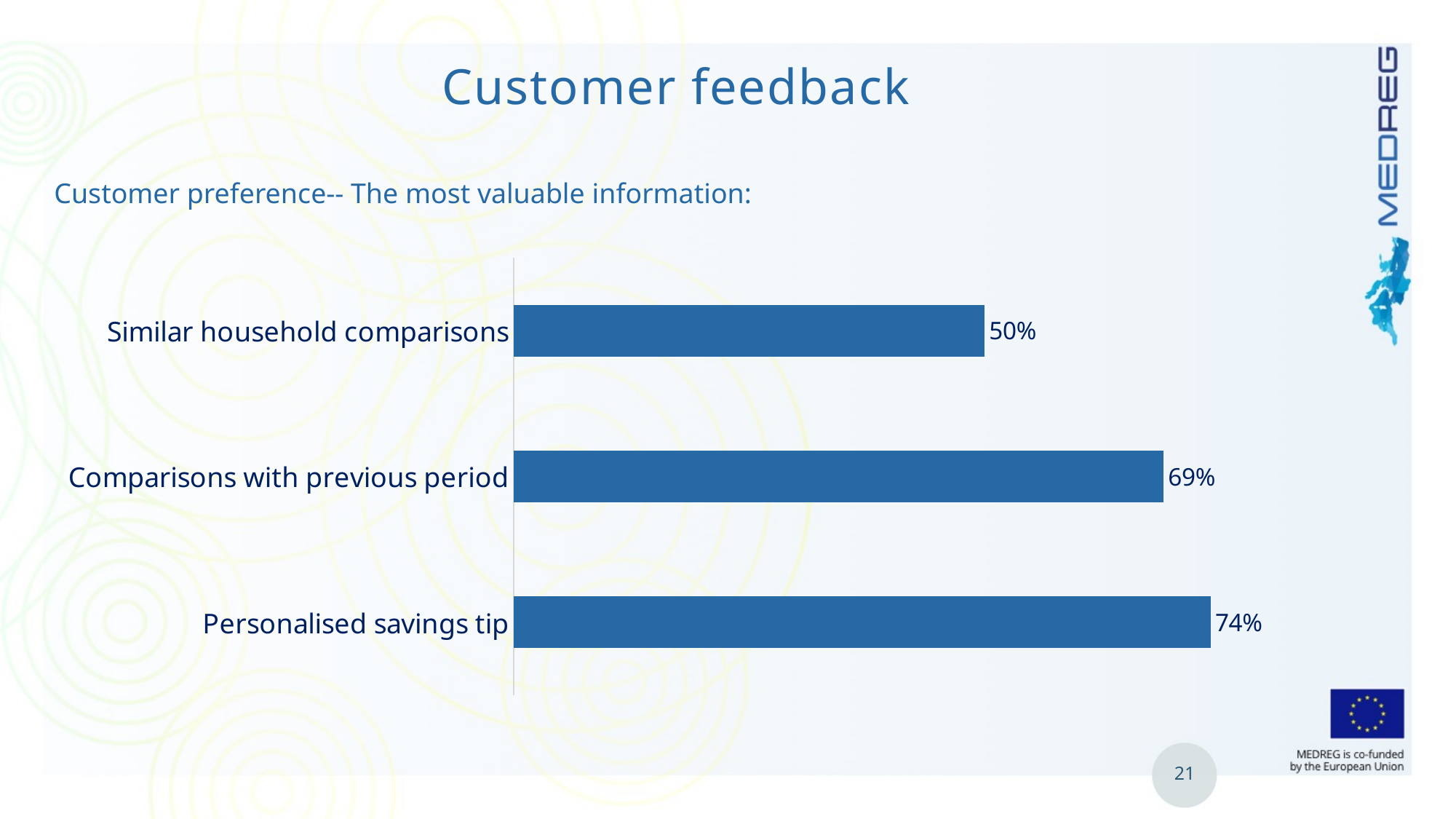
What is the value for Similar household comparisons? 50% What is the value for Comparisons with previous period? 69% Which is larger, the value for Comparisons with previous period or the value for Similar household comparisons? Comparisons with previous period How many categories are shown in the chart? 3 What is the title of the slide containing the chart? Customer feedback What kind of chart is shown on the slide? Bar chart What is the difference between the values for Comparisons with previous period and Similar household comparisons? 19% Which category has the highest value? Personalised savings tip What is the value for Personalised savings tip? 74% What is the difference between the values for Personalised savings tip and Similar household comparisons? 24% Which category has the lowest value? Similar household comparisons What colour are the bars in the chart? Blue